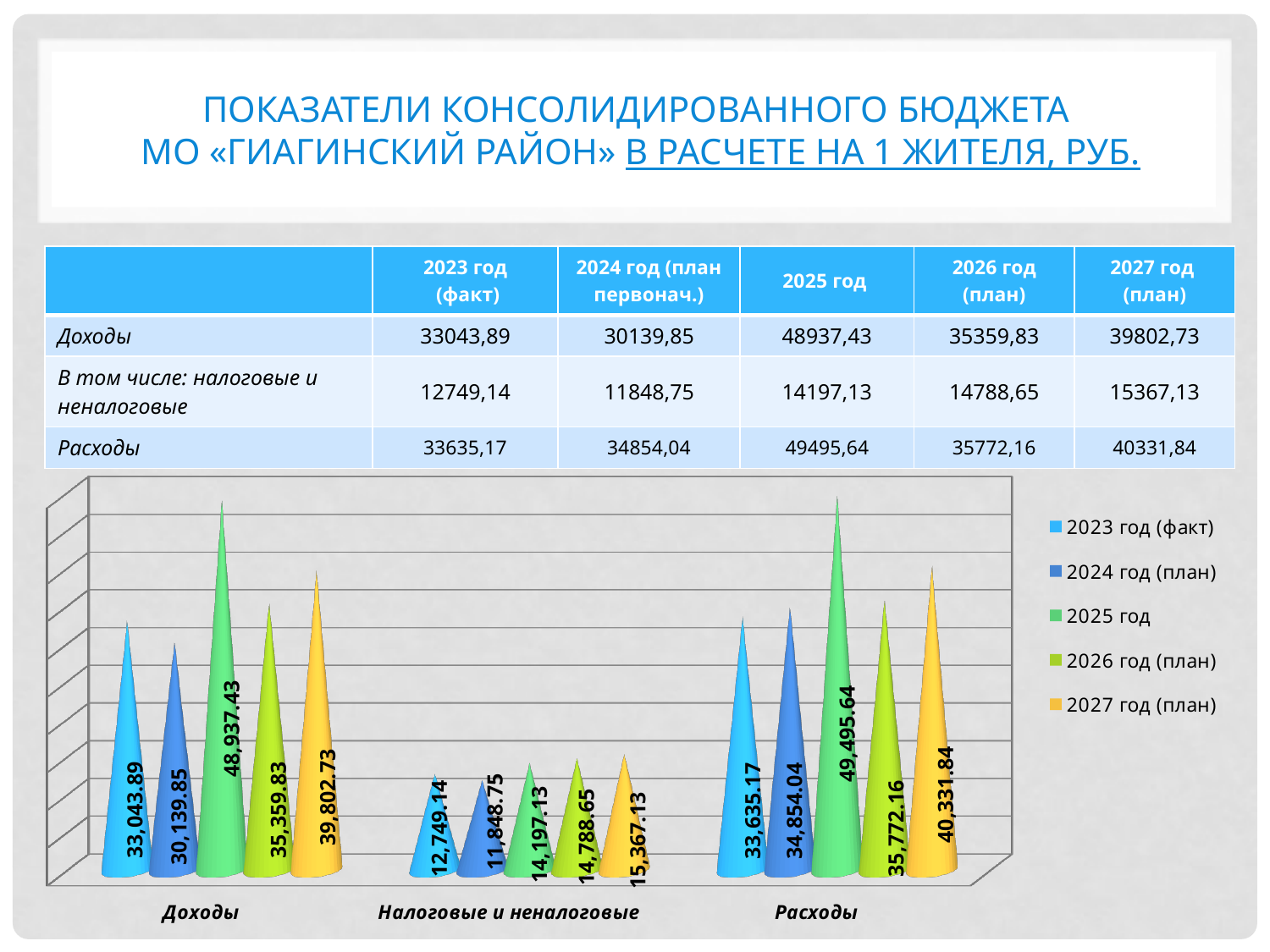
Which series has the lowest value for Доходы? 2024 год (план) Which is larger for the 2024 год (план) series: Доходы or Расходы? Расходы How many series does the chart legend list? 5 What is the value for Налоговые и неналоговые in the 2023 год (факт) series? 12,749.14 What is the value for Расходы in the 2027 год (план) series? 40,331.84 What is the value for Доходы in the 2025 год series? 48,937.43 What kind of chart is shown on the slide? bar chart How many categories are shown on the x axis of the chart? 3 What is the difference between Расходы and Доходы in the 2025 год series? 558.21 Do the values for Налоговые и неналоговые rise or fall from 2025 год to 2027 год (план)? rise Which series has the highest value for Расходы? 2025 год What is the difference between the 2027 год (план) and 2023 год (факт) values for Доходы? 6,758.84